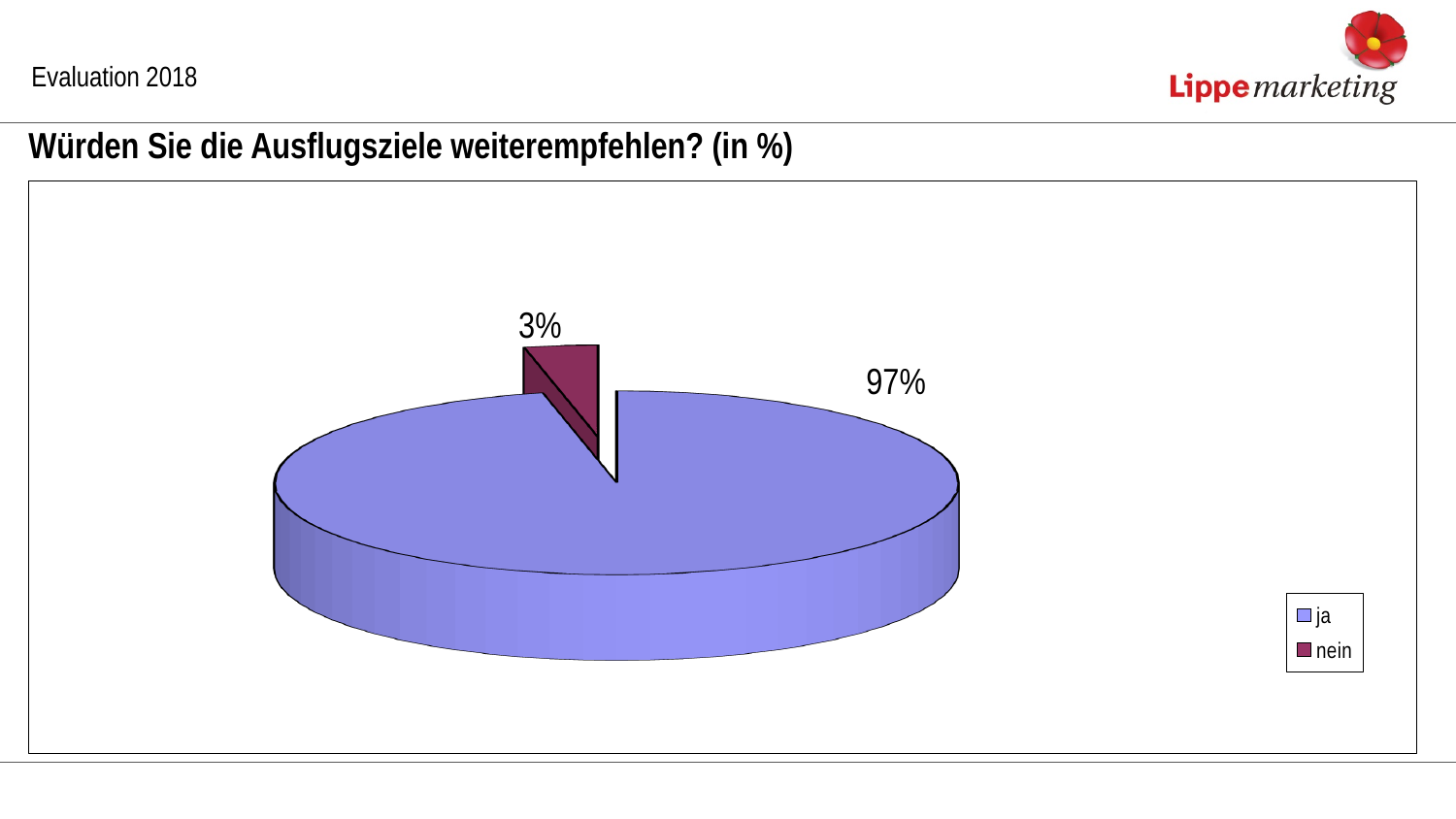
How many categories does the pie chart show? 2 Which is larger, the share for "ja" or the share for "nein"? ja What percentage of respondents answered "nein"? 3% Which category has the largest share of the pie? ja What colour is the "nein" slice in the pie chart? dark red What share of the pie does the "nein" slice represent? 3% What is the title of the chart on the slide? Würden Sie die Ausflugsziele weiterempfehlen? (in %) Which category has the smallest share of the pie? nein What percentage of respondents answered "ja"? 97% What kind of chart is shown on the slide? pie chart How many entries does the legend list? 2 What is the difference in percentage points between "ja" and "nein"? 94